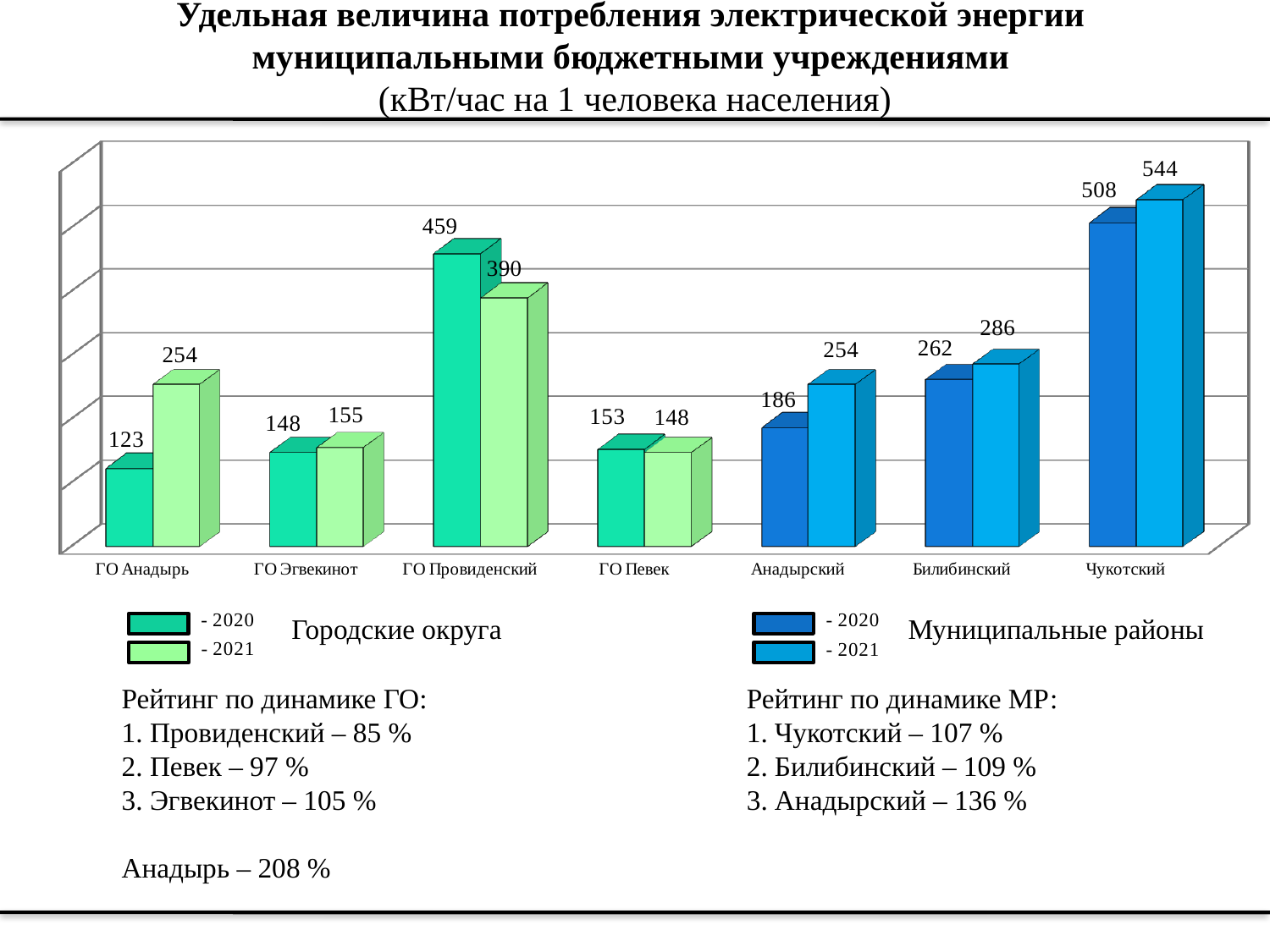
How many categories are shown on the x axis of the chart? 7 What is the 2021 value for ГО Провиденский? 390 Which category has the highest 2021 value? Чукотский What is the difference between the 2020 and 2021 values for ГО Провиденский? 69 Which category has the lowest 2020 value? ГО Анадырь Which is larger for ГО Певек: the 2020 value or the 2021 value? 2020 What type of chart is shown on the slide? Bar chart What is the difference between the 2021 and 2020 values for Чукотский? 36 What is the 2020 value for Билибинский? 262 What is the 2021 value for ГО Анадырь? 254 Which two years are listed in the chart legend? 2020 and 2021 Which is larger: the 2021 value for Анадырский or the 2021 value for ГО Эгвекинот? Анадырский